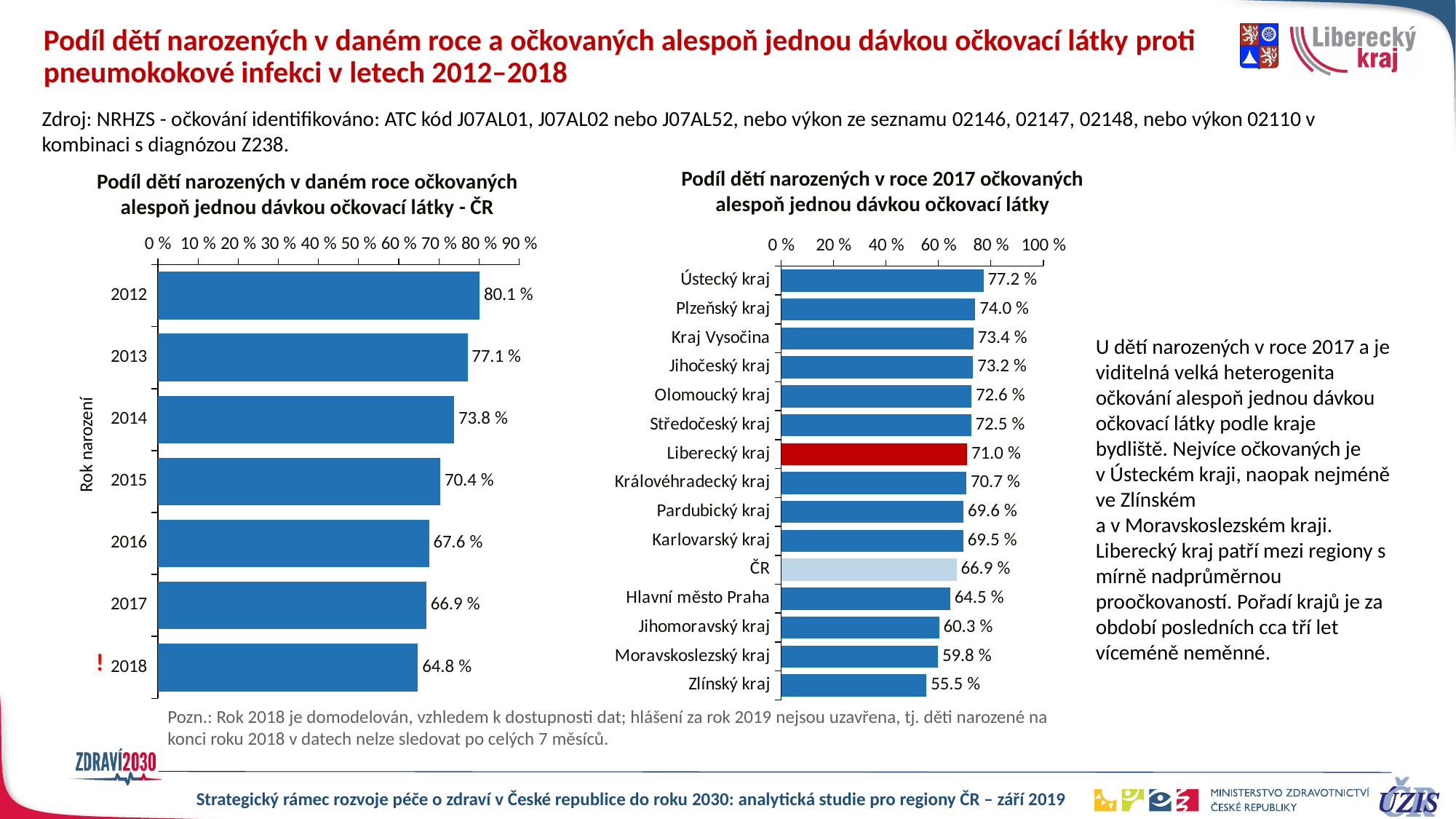
In the left chart (ČR by birth year), do the values rise or fall from 2012 to 2018? fall What type of chart is the right chart (children born in 2017 by region)? bar chart In the right chart (children born in 2017 by region), which is larger, the value for Jihomoravský kraj or the value for Hlavní město Praha? Hlavní město Praha In the right chart (children born in 2017 by region), what is the value for Liberecký kraj? 71.0 % In the left chart (ČR by birth year), what is the value for 2012? 80.1 % In the right chart (children born in 2017 by region), which region has the highest value? Ústecký kraj In the left chart (ČR by birth year), what is the value for 2016? 67.6 % In the left chart (ČR by birth year), which birth year has the lowest value? 2018 In the left chart (ČR by birth year), what is the difference between the values for 2012 and 2018? 15.3 % In the right chart (children born in 2017 by region), what is the difference between Ústecký kraj and Zlínský kraj? 21.7 % In the right chart (children born in 2017 by region), which region has the lowest value? Zlínský kraj In the left chart (ČR by birth year), how many birth years are shown? 7